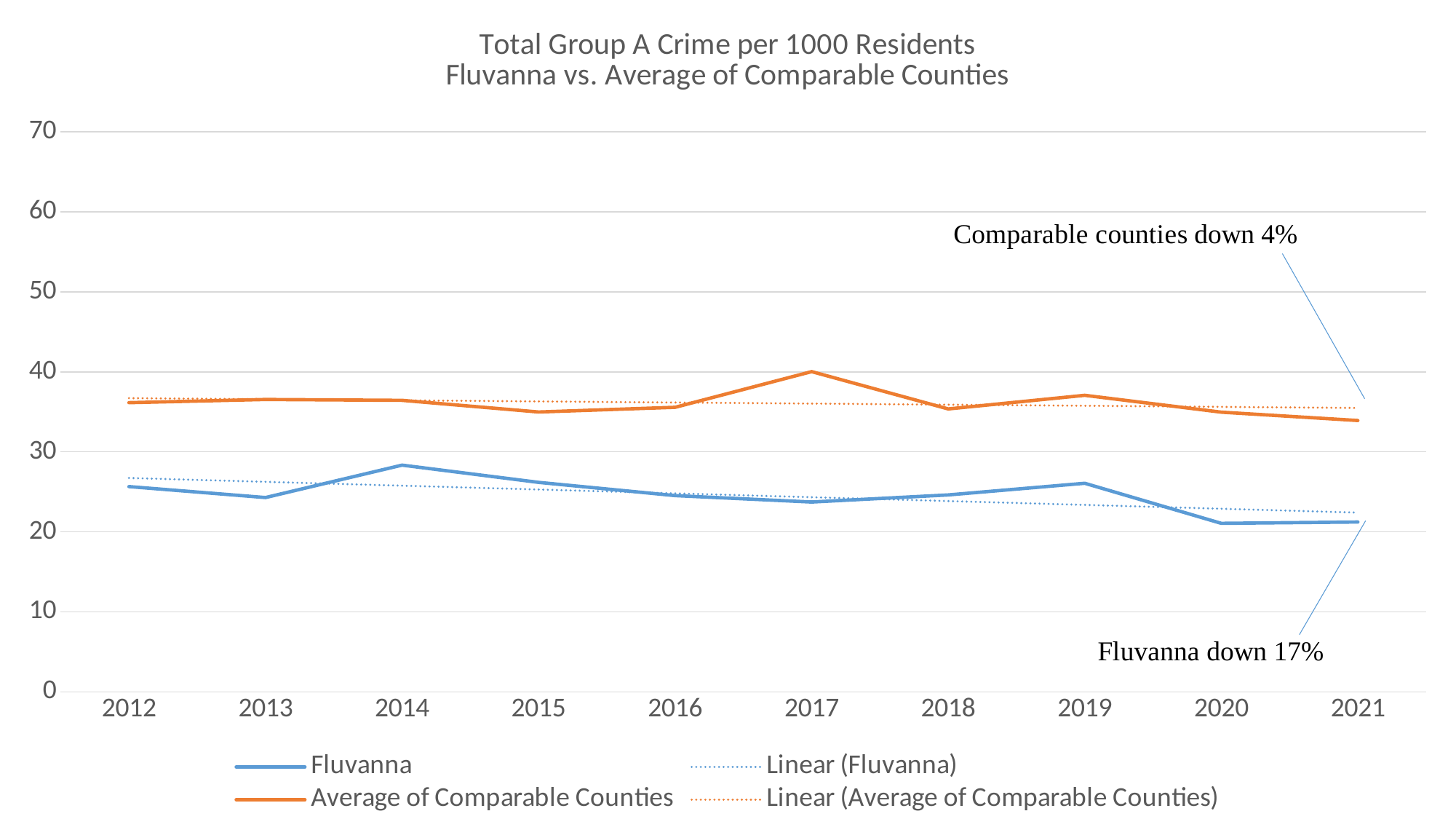
In which year is the Fluvanna value highest? 2014 How many years are shown on the x axis? 10 Which series is higher in 2017, Fluvanna or Average of Comparable Counties? Average of Comparable Counties In which year is the Average of Comparable Counties value highest? 2017 What kind of chart is shown on the slide? line chart Does the Fluvanna line overall rise or fall from 2012 to 2021? fall Is the Average of Comparable Counties value for 2021 greater or less than 40? less In which year is the Average of Comparable Counties value lowest? 2021 According to the annotation on the chart, by what percentage is Fluvanna down? 17% Is the Fluvanna value for 2020 greater or less than 30? less How many series does the legend list? 4 Is the Average of Comparable Counties value for 2017 greater or less than 30? greater